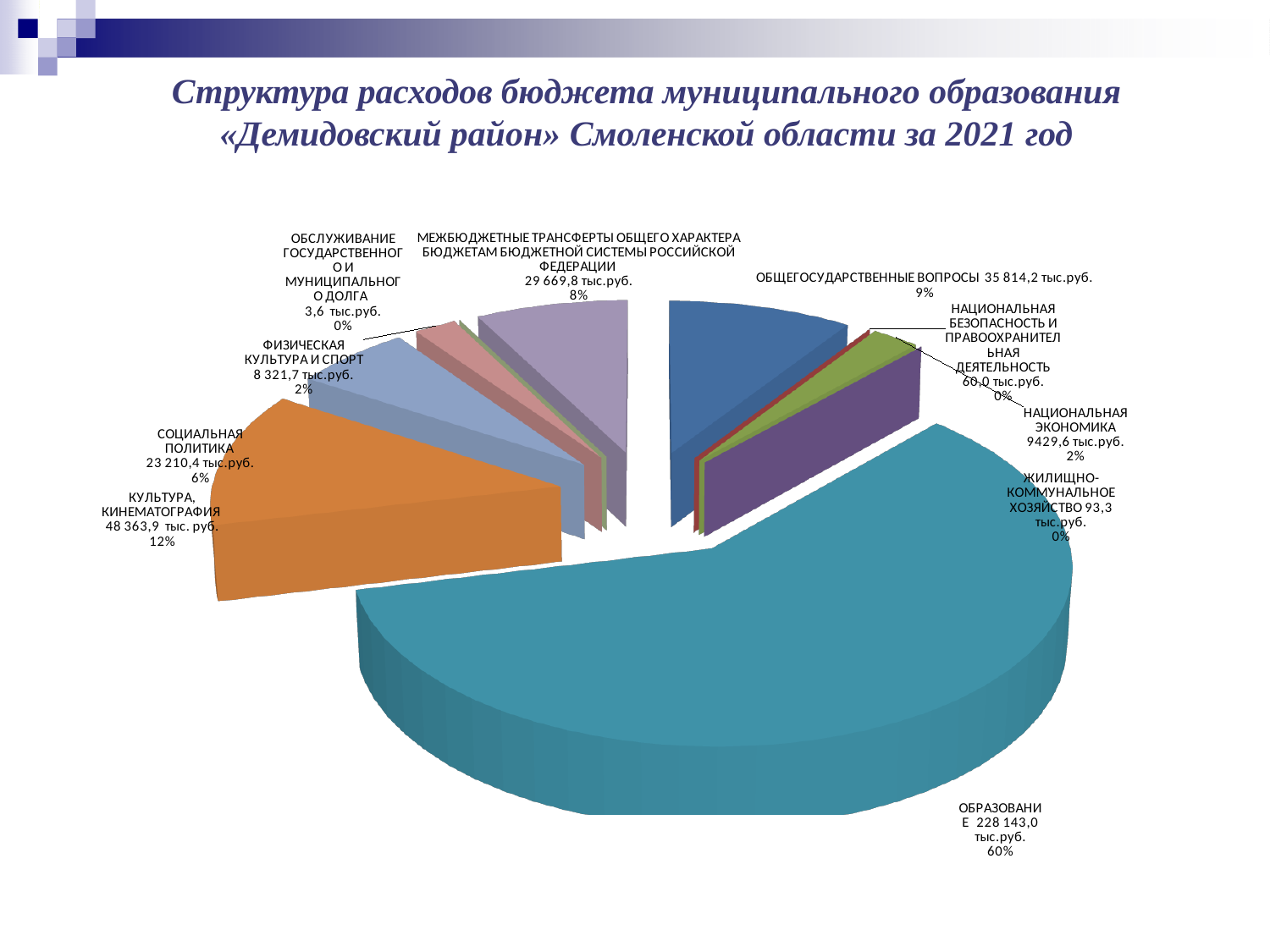
What share of the pie does ОБРАЗОВАНИЕ account for? 60% Which category has the largest slice of the pie? ОБРАЗОВАНИЕ How many categories (slices) does the pie chart show? 10 What is the value for НАЦИОНАЛЬНАЯ ЭКОНОМИКА? 9429,6 тыс.руб. What is the value for КУЛЬТУРА, КИНЕМАТОГРАФИЯ? 48 363,9 тыс. руб. Which category has the smallest value? ОБСЛУЖИВАНИЕ ГОСУДАРСТВЕННОГО И МУНИЦИПАЛЬНОГО ДОЛГА What percentage is shown for ОБЩЕГОСУДАРСТВЕННЫЕ ВОПРОСЫ? 9% What type of chart is shown on the slide? pie chart Which is larger: СОЦИАЛЬНАЯ ПОЛИТИКА or МЕЖБЮДЖЕТНЫЕ ТРАНСФЕРТЫ ОБЩЕГО ХАРАКТЕРА БЮДЖЕТАМ БЮДЖЕТНОЙ СИСТЕМЫ РОССИЙСКОЙ ФЕДЕРАЦИИ? МЕЖБЮДЖЕТНЫЕ ТРАНСФЕРТЫ ОБЩЕГО ХАРАКТЕРА БЮДЖЕТАМ БЮДЖЕТНОЙ СИСТЕМЫ РОССИЙСКОЙ ФЕДЕРАЦИИ What is the value for ОБРАЗОВАНИЕ? 228 143,0 тыс.руб. What is the title of the chart on the slide? Структура расходов бюджета муниципального образования «Демидовский район» Смоленской области за 2021 год What is the value for ЖИЛИЩНО-КОММУНАЛЬНОЕ ХОЗЯЙСТВО? 93,3 тыс.руб.